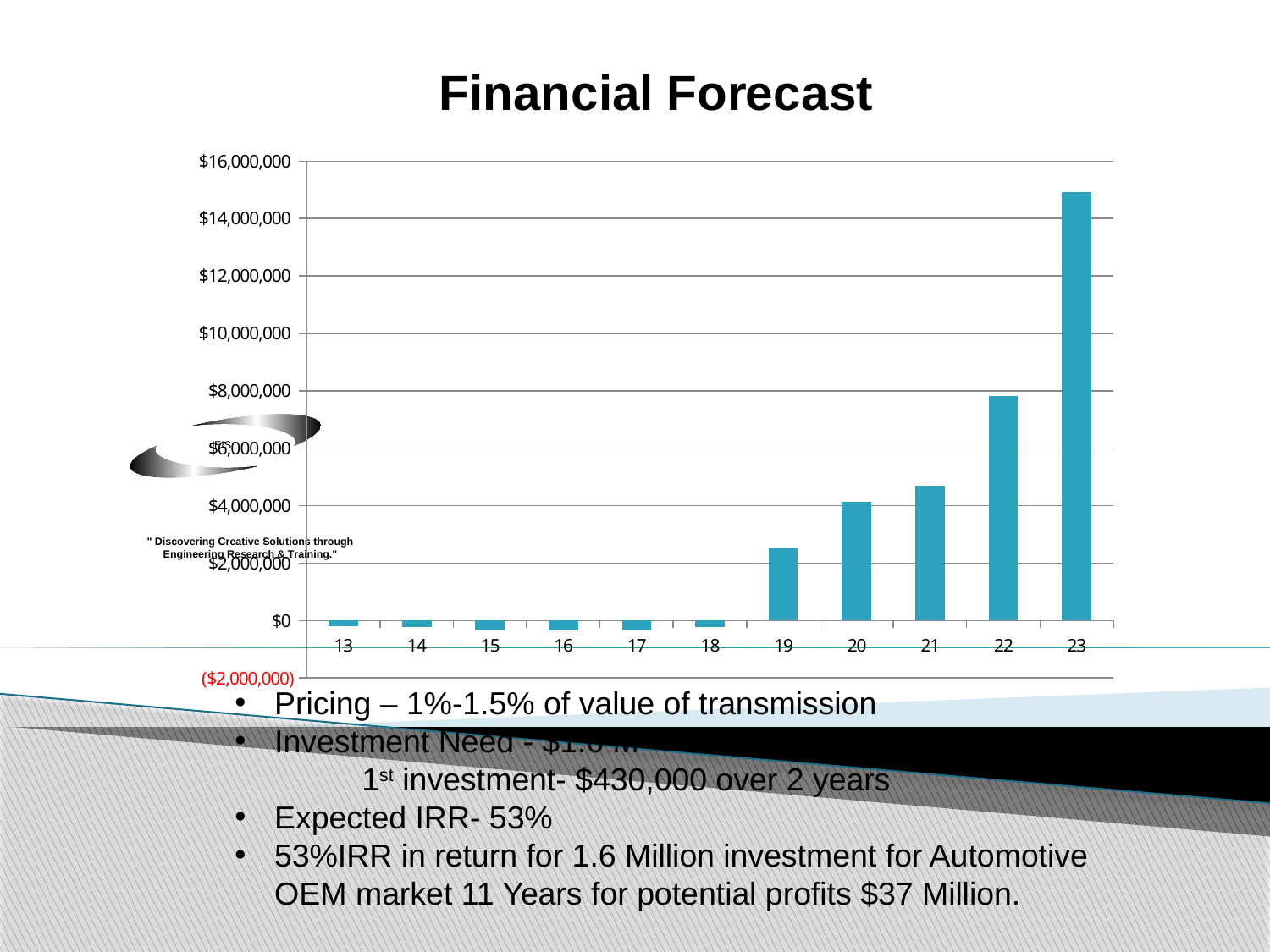
What is the title of the slide containing the chart? Financial Forecast Is the value for year 23 greater or less than $14,000,000? greater Is the value for year 21 greater or less than $4,000,000? greater Which year has the highest value in the chart? 23 Which is larger, the value for year 23 or the value for year 22? 23 How many categories (years) are shown on the x axis of the chart? 11 What kind of chart is shown on the slide? bar chart Which is larger, the value for year 22 or the value for year 21? 22 Is the value for year 19 greater or less than $2,000,000? greater Do the values generally rise or fall from year 19 to year 23? rise